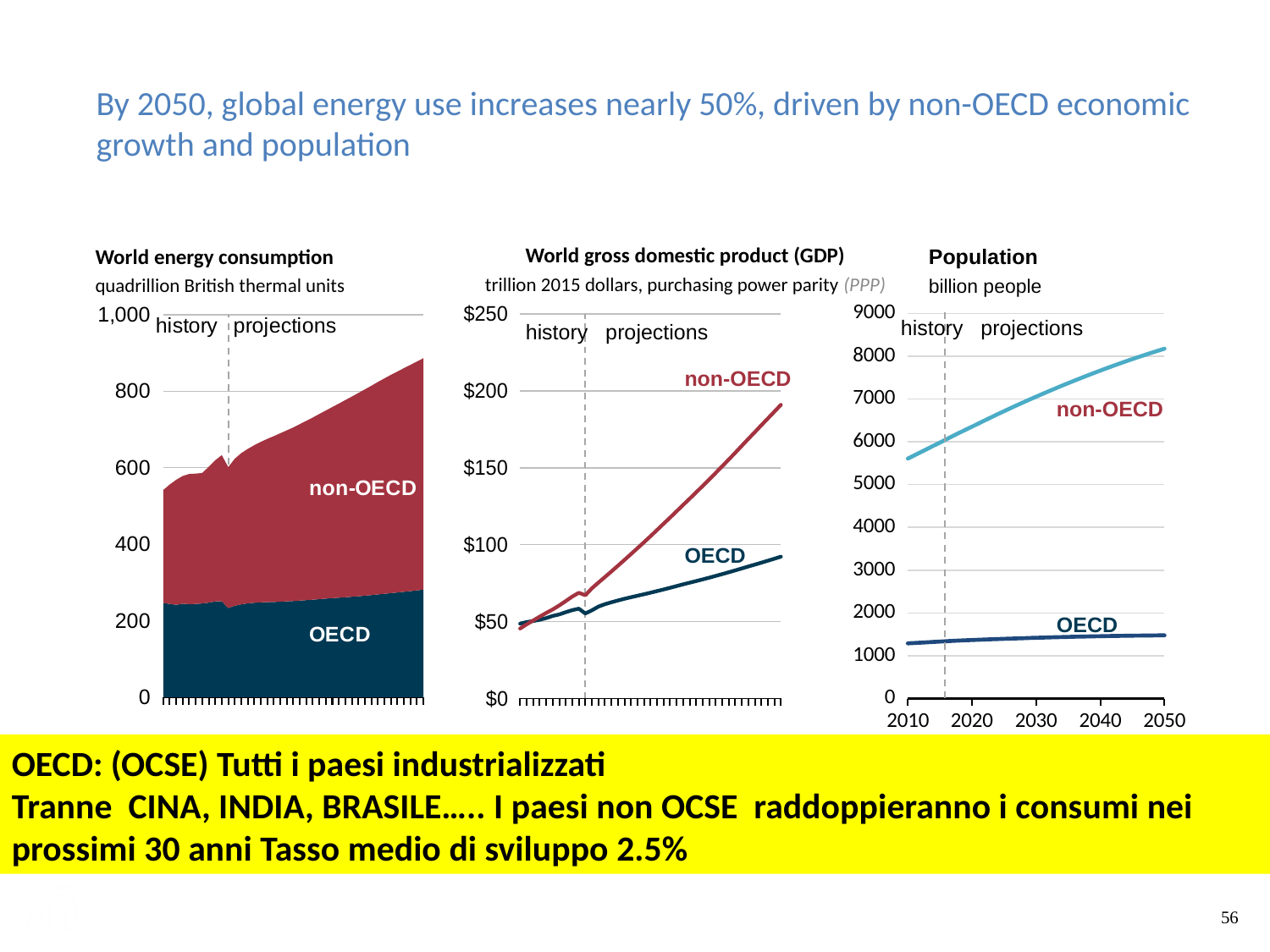
In the World gross domestic product (GDP) chart, is the OECD value at the end of the projection period greater or less than $100? less In the Population chart, is the OECD value in 2050 greater or less than 2000? less What unit is used on the World energy consumption chart? quadrillion British thermal units What kind of chart is the World energy consumption chart? area chart What is the last year shown on the x axis of the Population chart? 2050 In the World gross domestic product (GDP) chart, does the non-OECD line rise or fall over the projection period? rise In the Population chart, which series is larger in 2050, non-OECD or OECD? non-OECD How many series are plotted in the Population chart? 2 In the Population chart, is the non-OECD value in 2010 greater or less than 6000? less What kind of chart is the World gross domestic product (GDP) chart? line chart